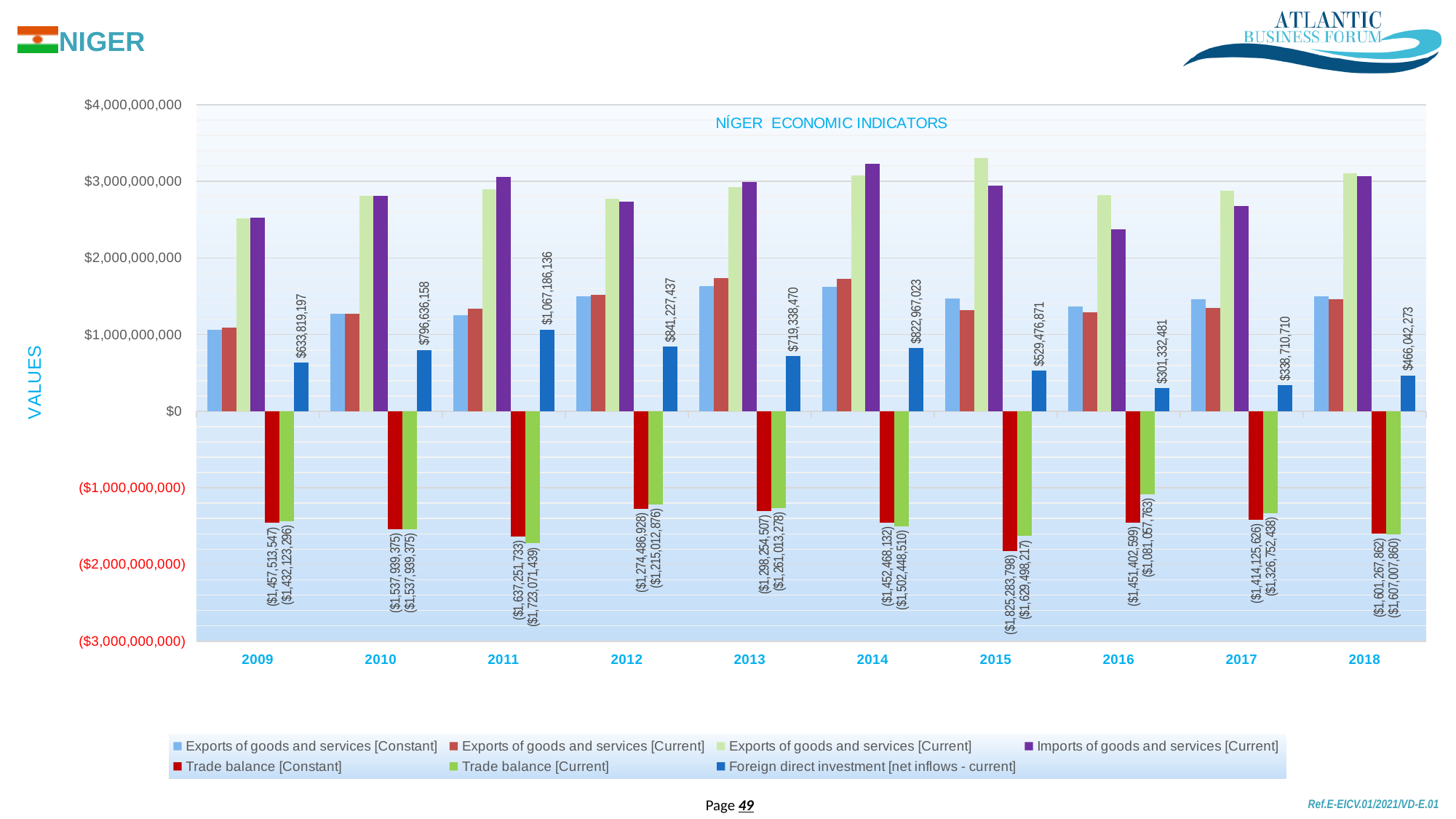
What is the value of Trade balance [Current] in 2016? ($1,081,057,763) In which year is Foreign direct investment [net inflows - current] lowest? 2016 How many years are shown on the x axis? 10 Is the value for Imports of goods and services [Current] in 2016 greater or less than $2,000,000,000? greater What is the title of the chart? NÍGER ECONOMIC INDICATORS Does Foreign direct investment [net inflows - current] rise or fall from 2014 to 2016? Fall Which is larger, Foreign direct investment in 2012 or in 2013? 2012 What is the difference between Foreign direct investment in 2011 and in 2016? $765,853,655 What is the value of Foreign direct investment [net inflows - current] in 2011? $1,067,186,136 How many series does the legend list? 7 What kind of chart is this? Bar chart In which year is Foreign direct investment [net inflows - current] highest? 2011